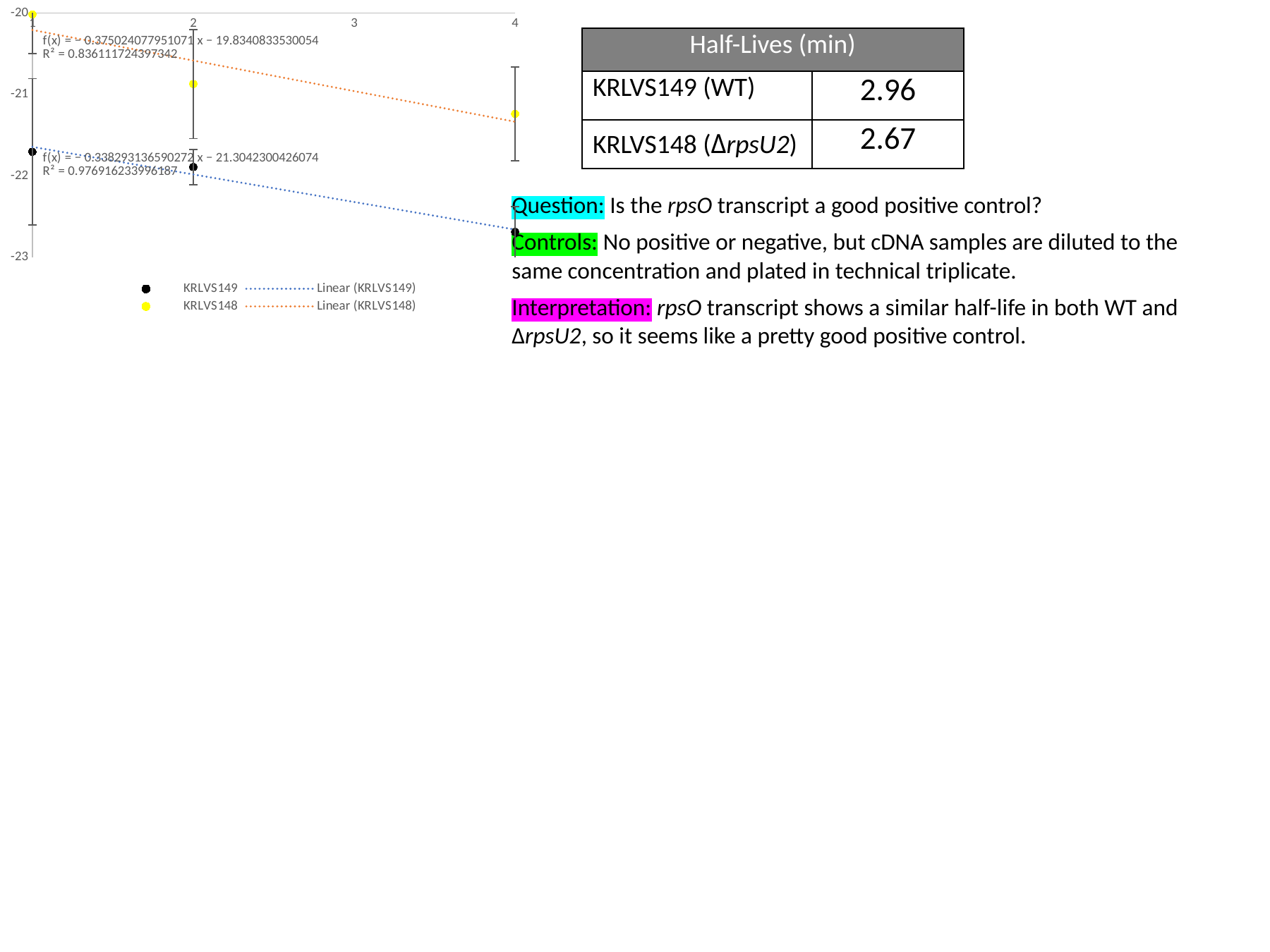
Is the value for KRLVS148 at x = 4 greater or less than -22? greater Do the plotted values for KRLVS148 rise or fall as x increases from 1 to 4? fall How many entries does the chart legend list? 4 Is the value for KRLVS149 at x = 4 greater or less than -22? less What colour are the markers for the KRLVS148 series? yellow At x = 4, which series has the lower plotted value, KRLVS149 or KRLVS148? KRLVS149 What R² value is printed for the trendline with the equation f(x) = -0.338293136590272 x - 21.3042300426074? 0.976916233996187 How many data points are plotted for the KRLVS149 series? 3 What kind of chart is shown on the slide? scatter chart At x = 2, which series has the higher plotted value, KRLVS149 or KRLVS148? KRLVS148 Do the plotted values for KRLVS149 rise or fall as x increases from 1 to 4? fall Is the value for KRLVS148 at x = 2 greater or less than -21? greater